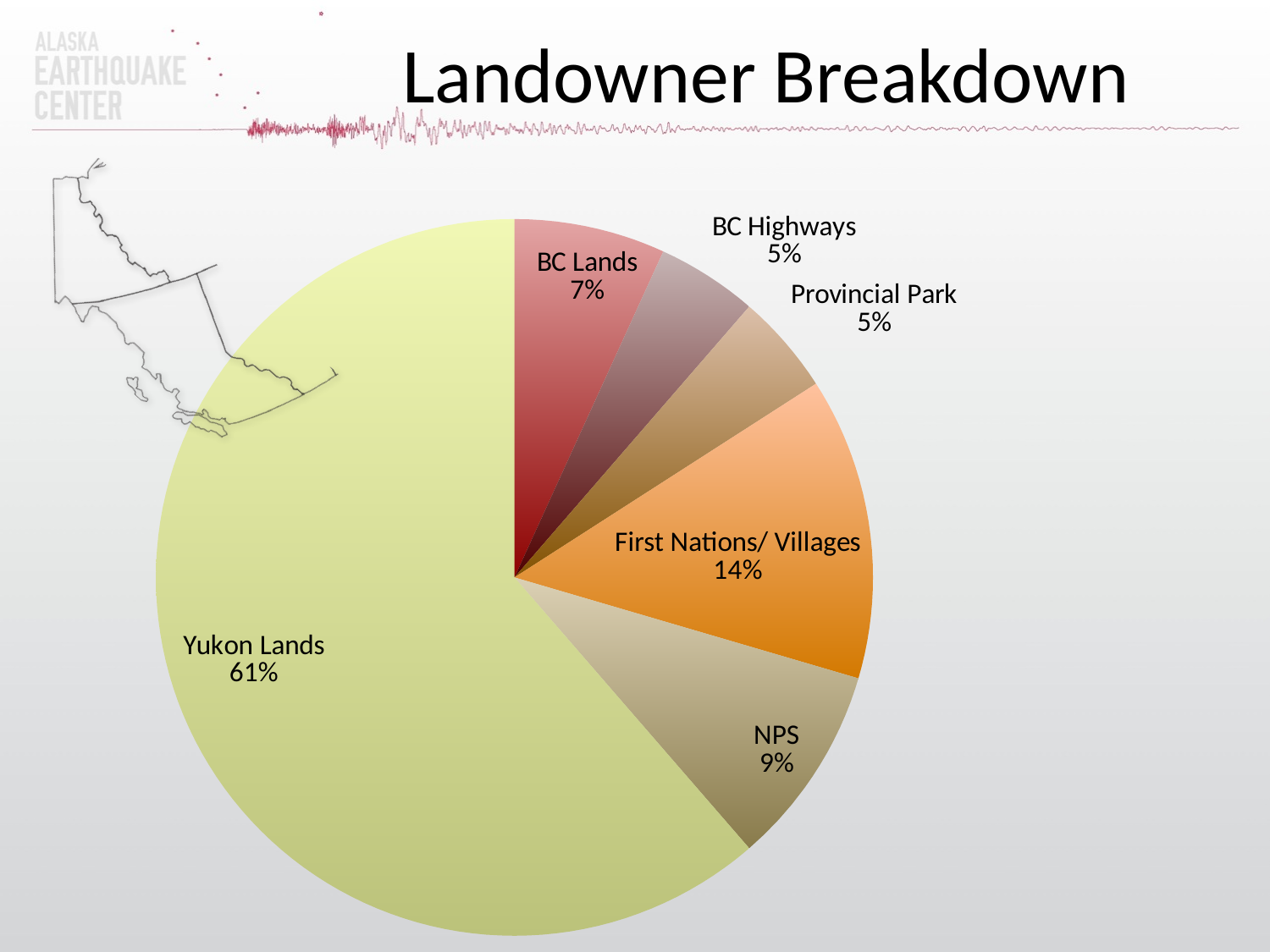
What is the combined percentage of BC Highways and Provincial Park? 10% What type of chart is shown on the slide? pie chart What percentage is shown for NPS? 9% What percentage is shown for BC Lands? 7% What is the difference in percentage points between First Nations/ Villages and NPS? 5 What percentage is shown for First Nations/ Villages? 14% What percentage is shown for Provincial Park? 5% What share of the pie is Yukon Lands? 61% Which is larger, the share for NPS or the share for BC Lands? NPS What is the title of the chart? Landowner Breakdown Which category has the largest slice of the pie? Yukon Lands How many slices does the pie chart have? 6